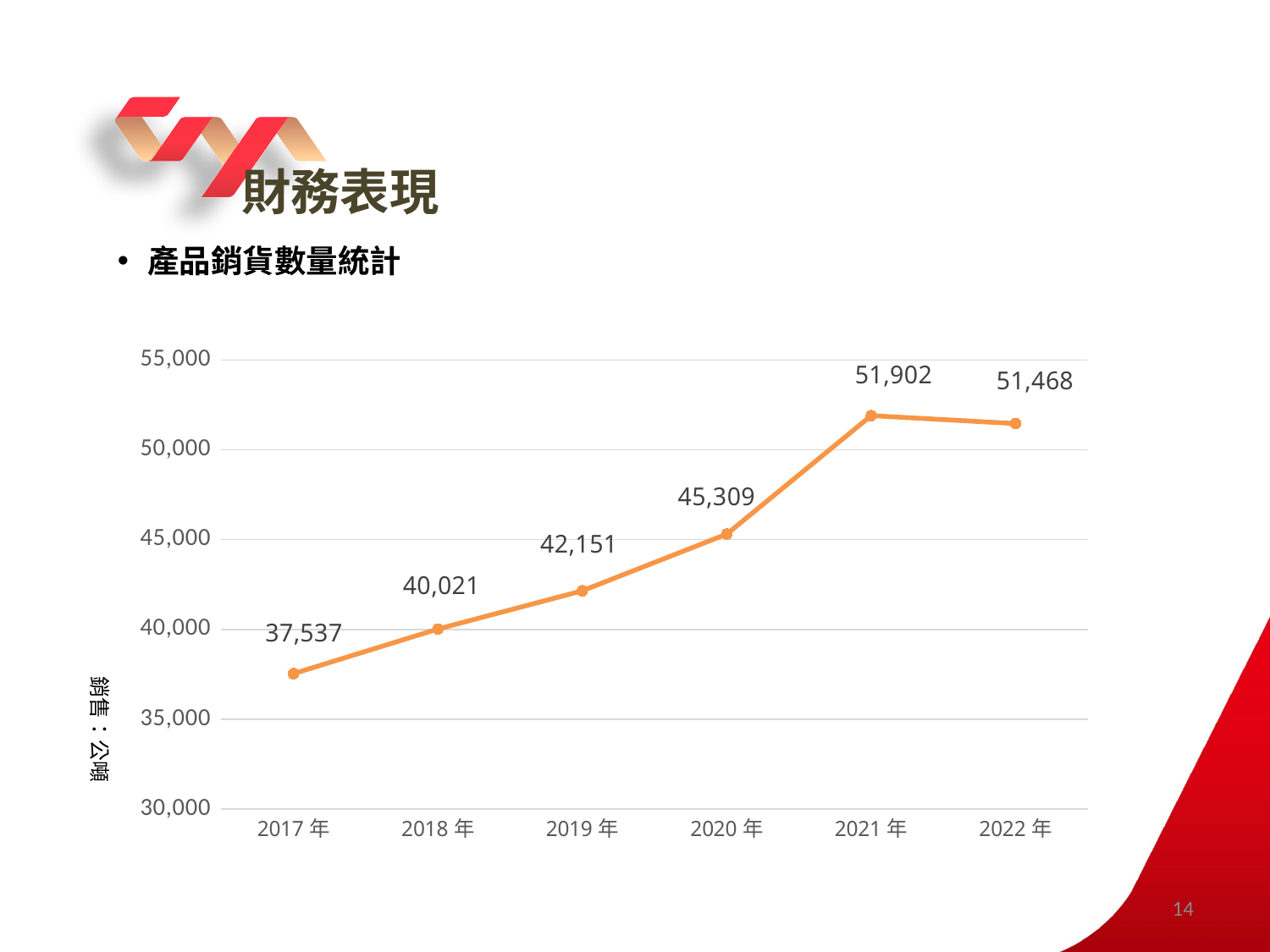
Which year has the lowest sales volume? 2017 年 Which year has the highest sales volume? 2021 年 What is the unit label shown on the vertical axis? 銷售：公噸 What is the sales volume for 2020 年? 45,309 What kind of chart is shown on the slide? line chart Is the value for 2019 年 greater or less than 40,000? greater What is the difference between the sales volume in 2018 年 and 2017 年? 2,484 Which year has a larger sales volume, 2019 年 or 2020 年? 2020 年 What is the sales volume for 2022 年? 51,468 What is the sales volume for 2017 年? 37,537 What is the difference between the sales volume in 2021 年 and 2022 年? 434 How many years are plotted on the chart? 6